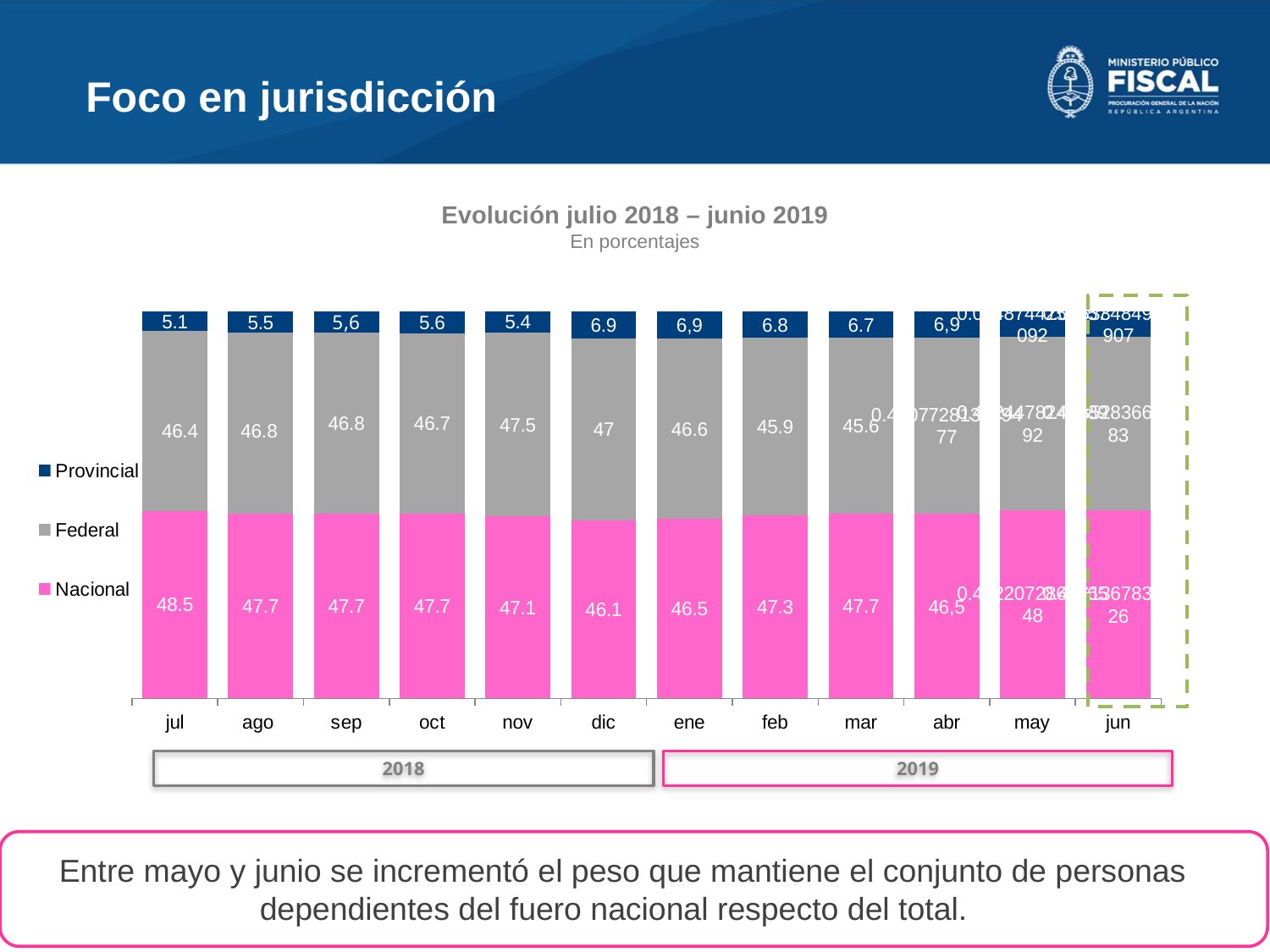
What is the Nacional value for feb? 47.3 In dic, which is larger, the Federal value or the Nacional value? Federal How many series does the legend list? 3 What kind of chart is shown on the slide? Stacked bar chart Among the 2018 months (jul to dic), which month has the highest Nacional value? jul What is the Nacional value for jul? 48.5 What is the total of the stacked bar for jul? 100 Among the 2018 months (jul to dic), which month has the lowest Provincial value? jul What is the Provincial value for dic? 6.9 What is the difference between the Nacional value for jul and the Nacional value for ago? 0.8 What is the Federal value for nov? 47.5 How many months are shown on the x axis? 12